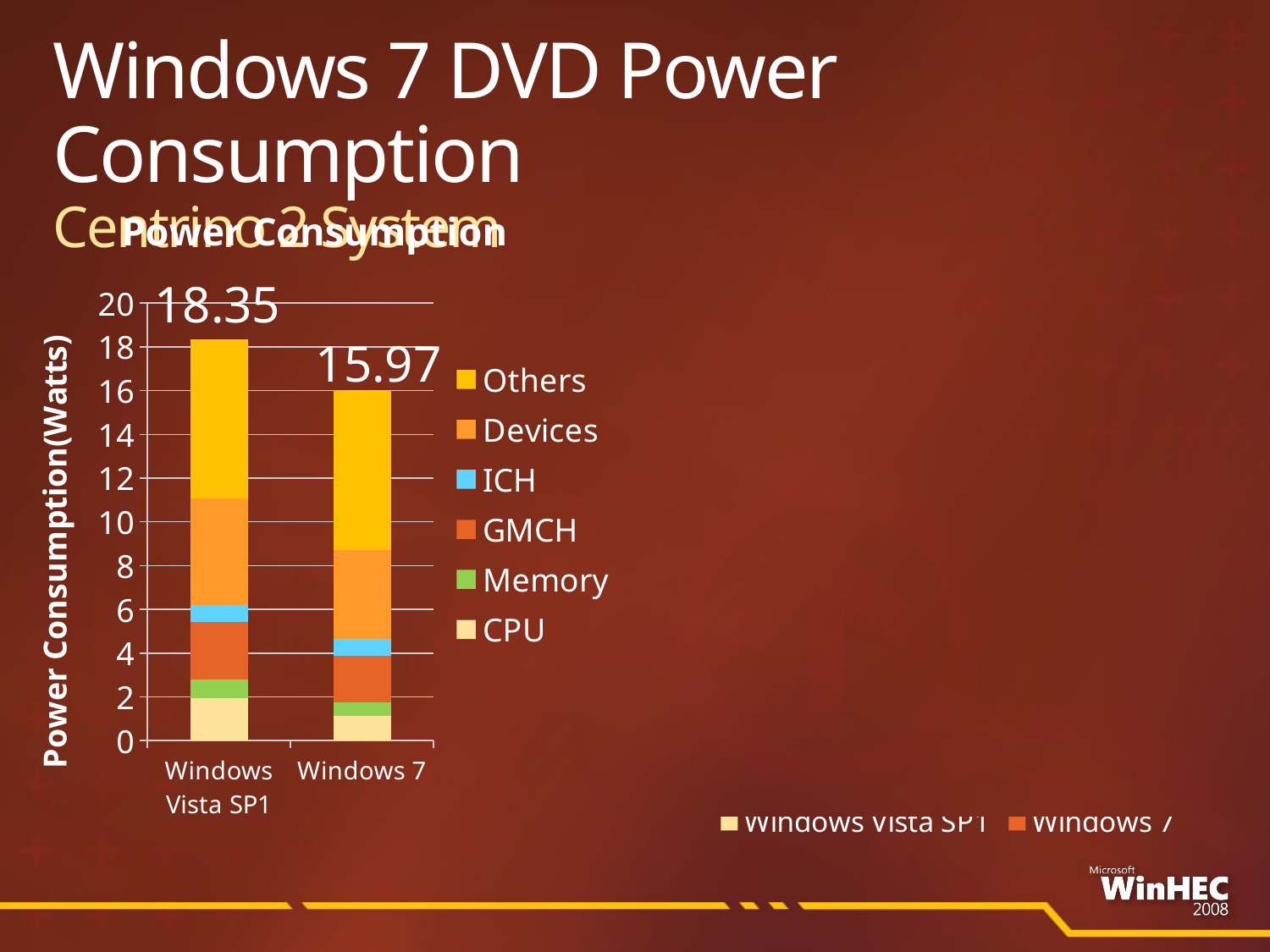
What kind of chart is shown on the slide? stacked bar chart What is the total power consumption shown for Windows Vista SP1? 18.35 What is the difference between the total power consumption of Windows Vista SP1 and Windows 7? 2.38 Does the total power consumption rise or fall from Windows Vista SP1 to Windows 7? fall How many categories are plotted on the x axis? 2 How many series does the chart legend list? 6 Which category has the lower total power consumption? Windows 7 What is the label of the vertical axis? Power Consumption(Watts) Is the total for Windows 7 larger or smaller than the total for Windows Vista SP1? smaller Which category has the higher total power consumption? Windows Vista SP1 What is the total power consumption shown for Windows 7? 15.97 Which series is listed at the bottom of the chart legend? CPU